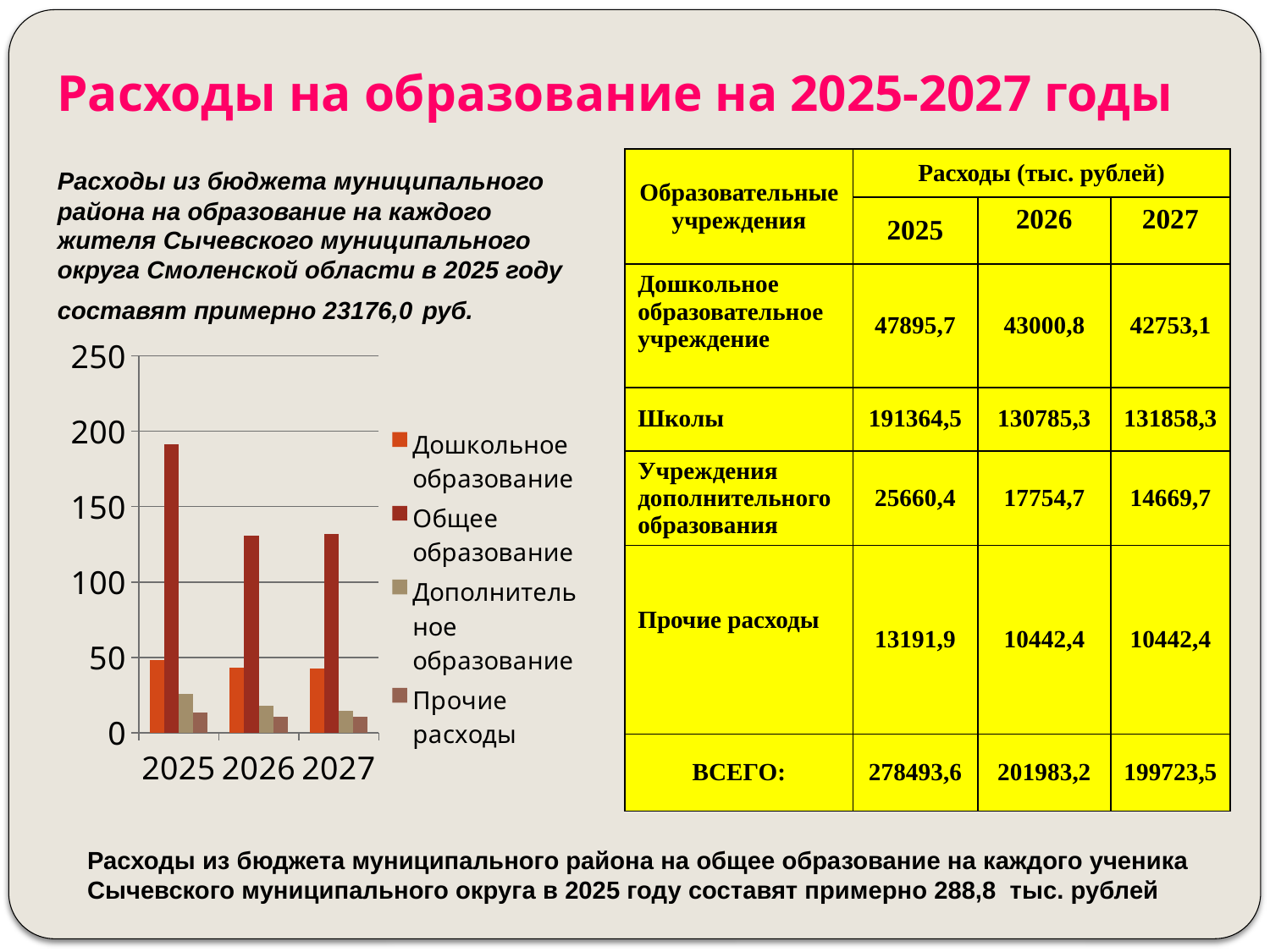
Which series is shown in dark red in the chart? Общее образование What kind of chart is shown on the slide? bar chart In which year is the value for Общее образование the highest? 2025 Does the value for Дополнительное образование rise or fall from 2025 to 2027? fall Which series has the lowest value in 2025? Прочие расходы Is the value for Дошкольное образование in 2025 greater or less than 100? less How many years (categories) are shown on the x axis of the chart? 3 Which is larger: Общее образование in 2025 or Общее образование in 2026? 2025 Is the value for Общее образование in 2026 greater or less than 100? greater Is the value for Прочие расходы in 2027 greater or less than 50? less How many series does the chart legend list? 4